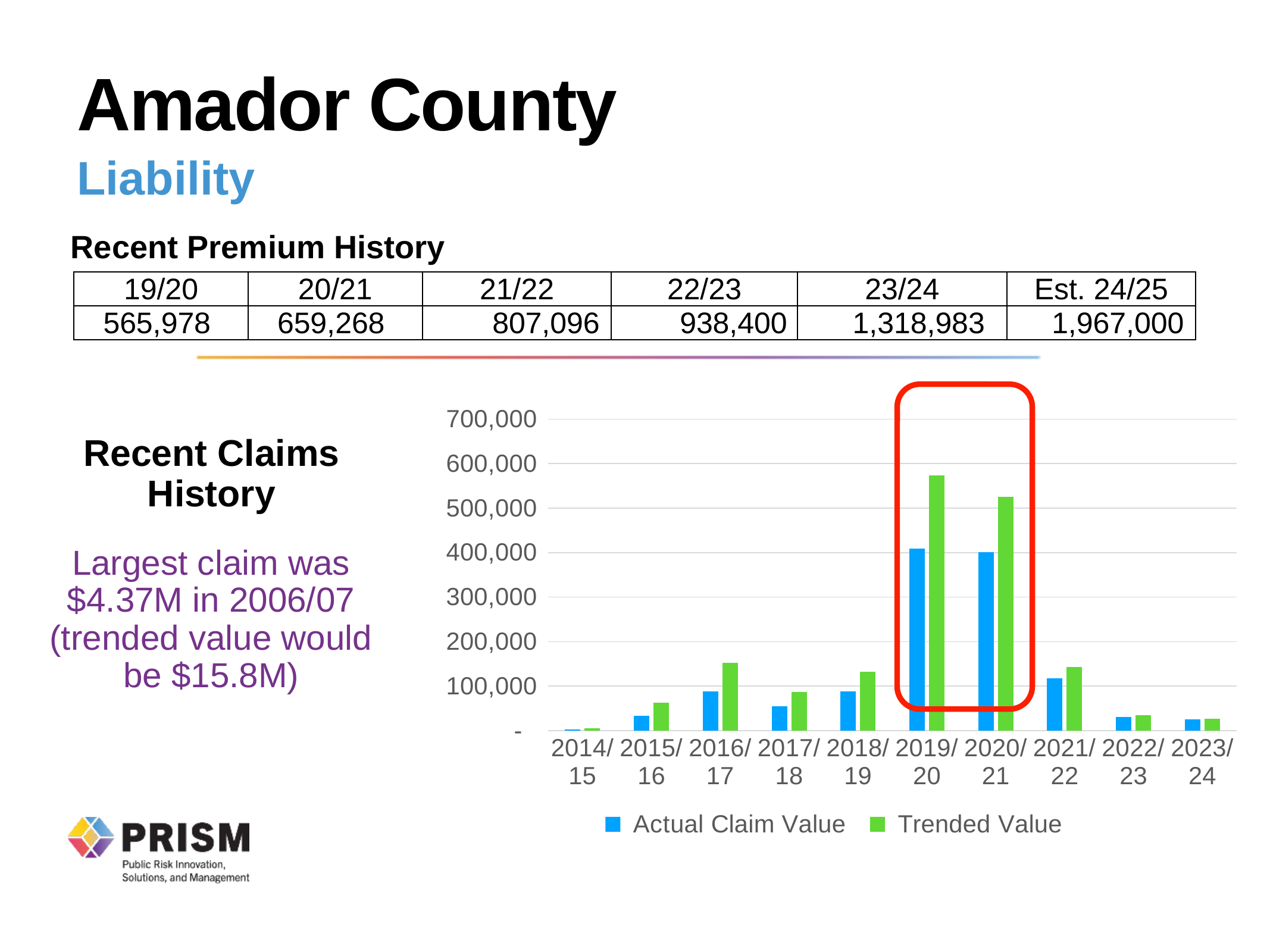
How many fiscal years are shown on the x axis of the claims chart? 10 What kind of chart is shown under Recent Claims History? bar chart Is the Trended Value for 2016/17 greater or less than 100,000? greater Is the Actual Claim Value for 2017/18 greater or less than 100,000? less Is the Trended Value for 2019/20 greater or less than 500,000? greater Which year has the lowest Actual Claim Value in the claims chart? 2014/15 In 2019/20, which is larger: the Actual Claim Value or the Trended Value? Trended Value Which year has the highest Trended Value in the claims chart? 2019/20 How many series does the legend of the claims chart list? 2 Which is larger: the Trended Value for 2016/17 or the Trended Value for 2017/18? 2016/17 Which two years are highlighted by the red box on the claims chart? 2019/20 and 2020/21